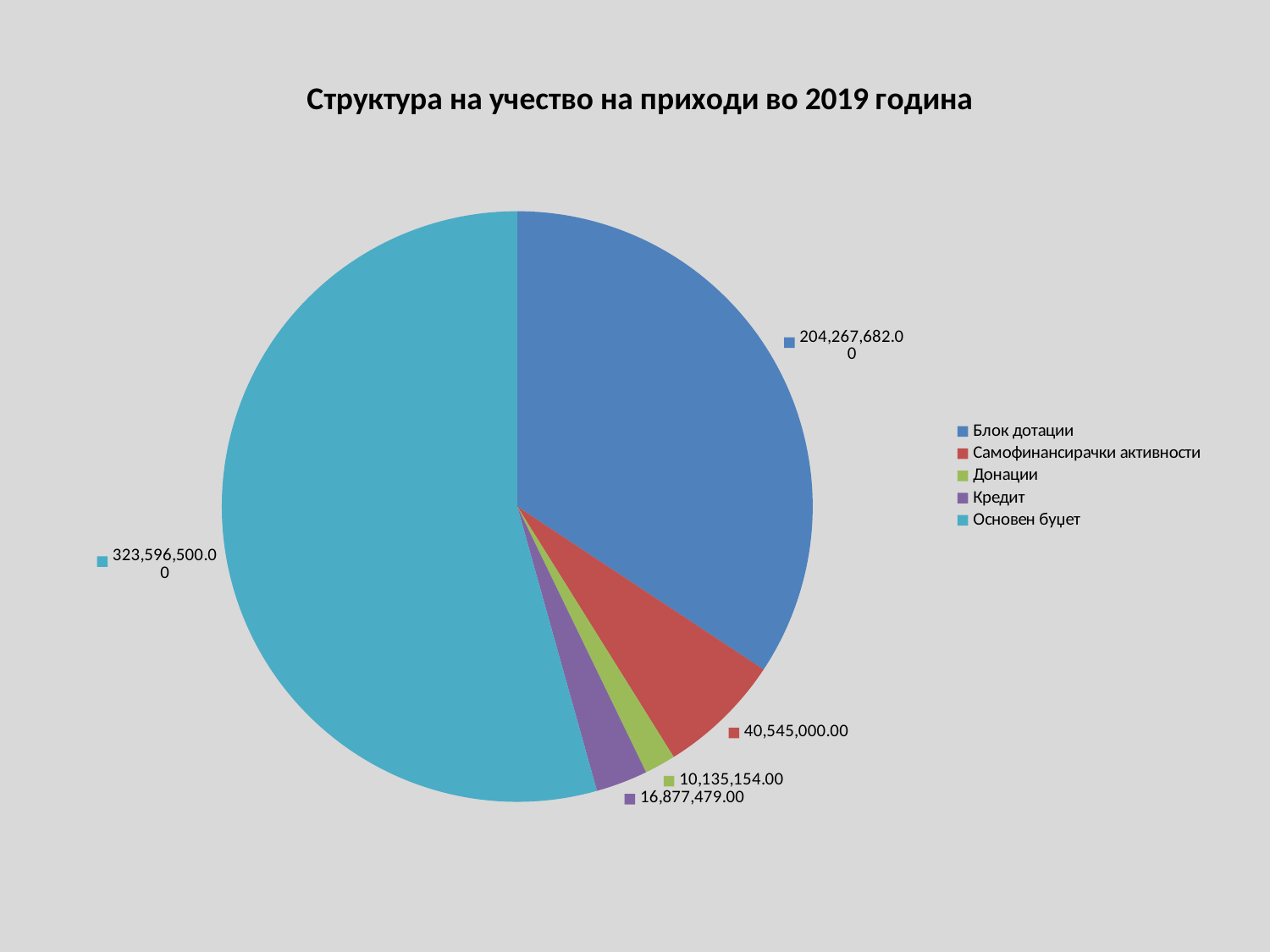
Which is larger, Кредит or Донации? Кредит How many categories does the pie chart have? 5 What is the difference between the values for Основен буџет and Блок дотации? 119,328,818.00 What type of chart is shown on the slide? pie chart What is the value for Блок дотации? 204,267,682.00 What is the value for Кредит? 16,877,479.00 Which category has the largest slice of the pie? Основен буџет What is the value for Основен буџет? 323,596,500.00 What is the value for Донации? 10,135,154.00 What is the value for Самофинансирачки активности? 40,545,000.00 What is the title of the chart? Структура на учество на приходи во 2019 година Which category has the smallest slice of the pie? Донации